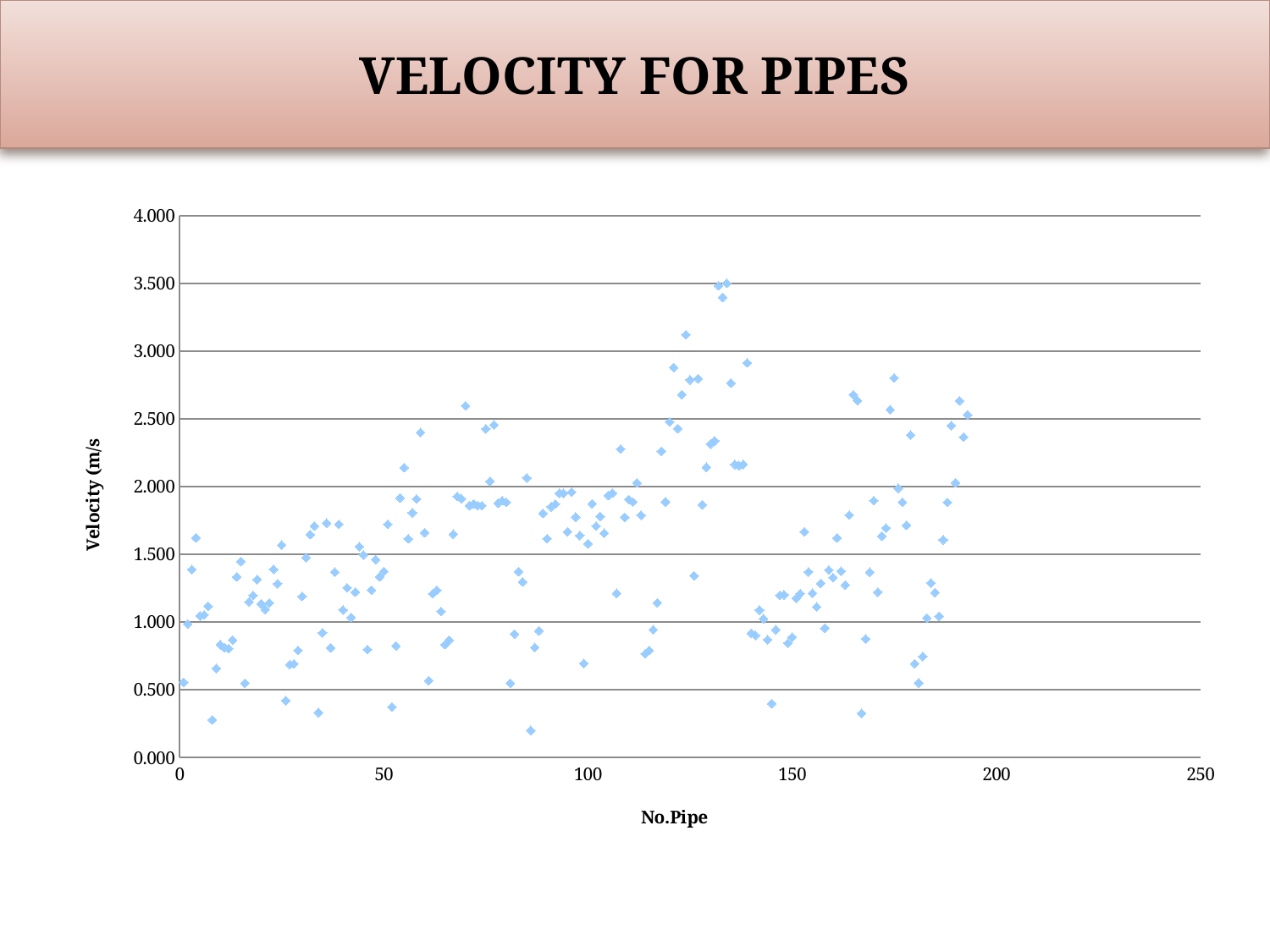
Is the velocity of the highest point on the chart greater or less than 2.500? greater Is the highest plotted velocity greater or less than 3.000? greater What kind of chart is shown on the slide? scatter chart What is the title of the x axis of the chart? No.Pipe What is the title of the y axis of the chart? Velocity (m/s Is the lowest plotted velocity greater or less than 0.500? less